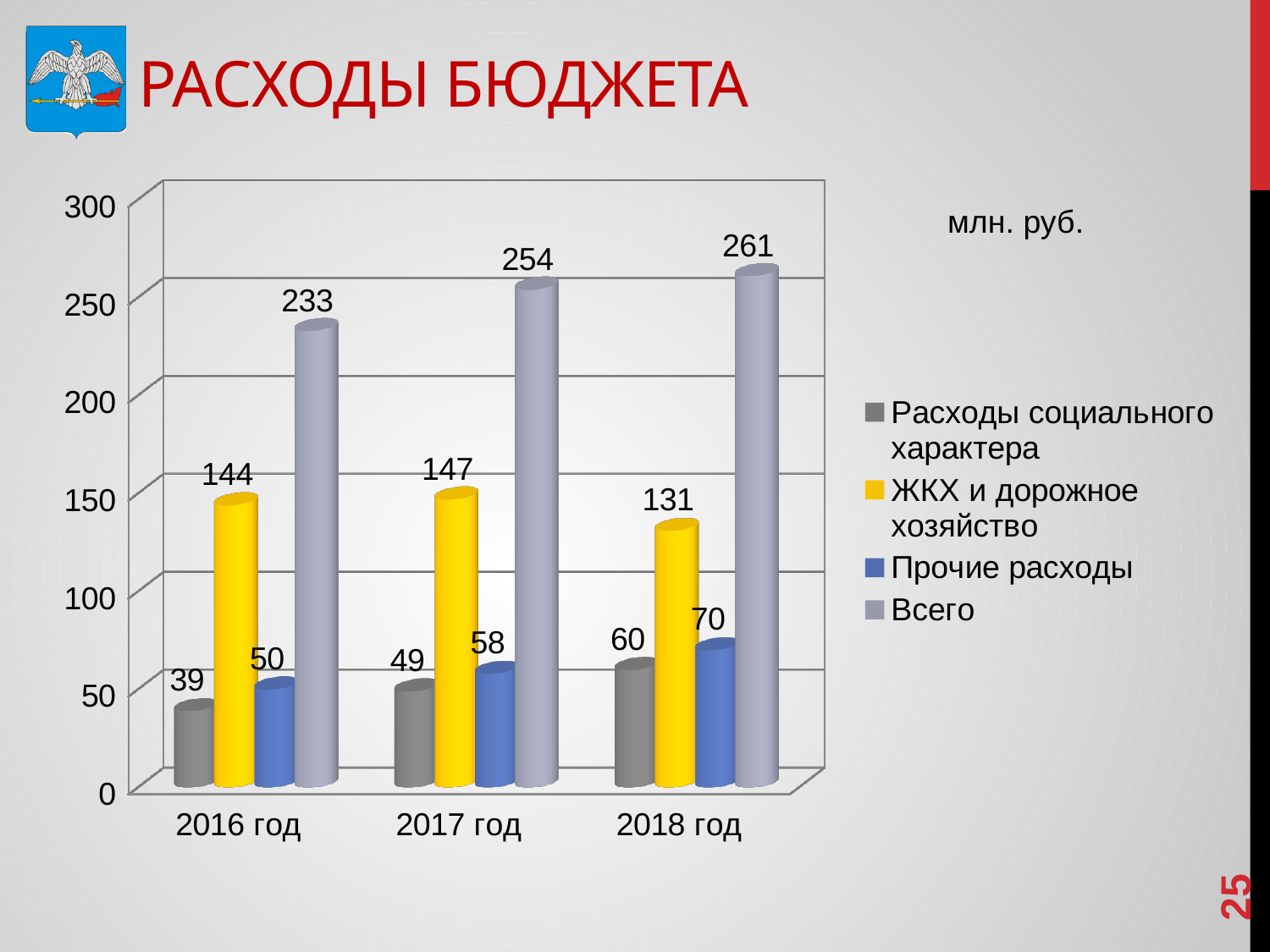
What is the difference between Всего in 2018 год and Всего in 2016 год? 28 What kind of chart is shown on the slide? bar chart What is the value for Прочие расходы in 2018 год? 70 In which year is ЖКХ и дорожное хозяйство the lowest? 2018 год How many years are shown on the x axis? 3 Which is larger: Расходы социального характера in 2018 год or Прочие расходы in 2016 год? Расходы социального характера in 2018 год What is the value for ЖКХ и дорожное хозяйство in 2016 год? 144 In which year is Всего the highest? 2018 год Do the values for Прочие расходы rise or fall from 2016 год to 2018 год? rise What is the value for Расходы социального характера in 2017 год? 49 How many series does the legend list? 4 What is the value for Всего in 2017 год? 254